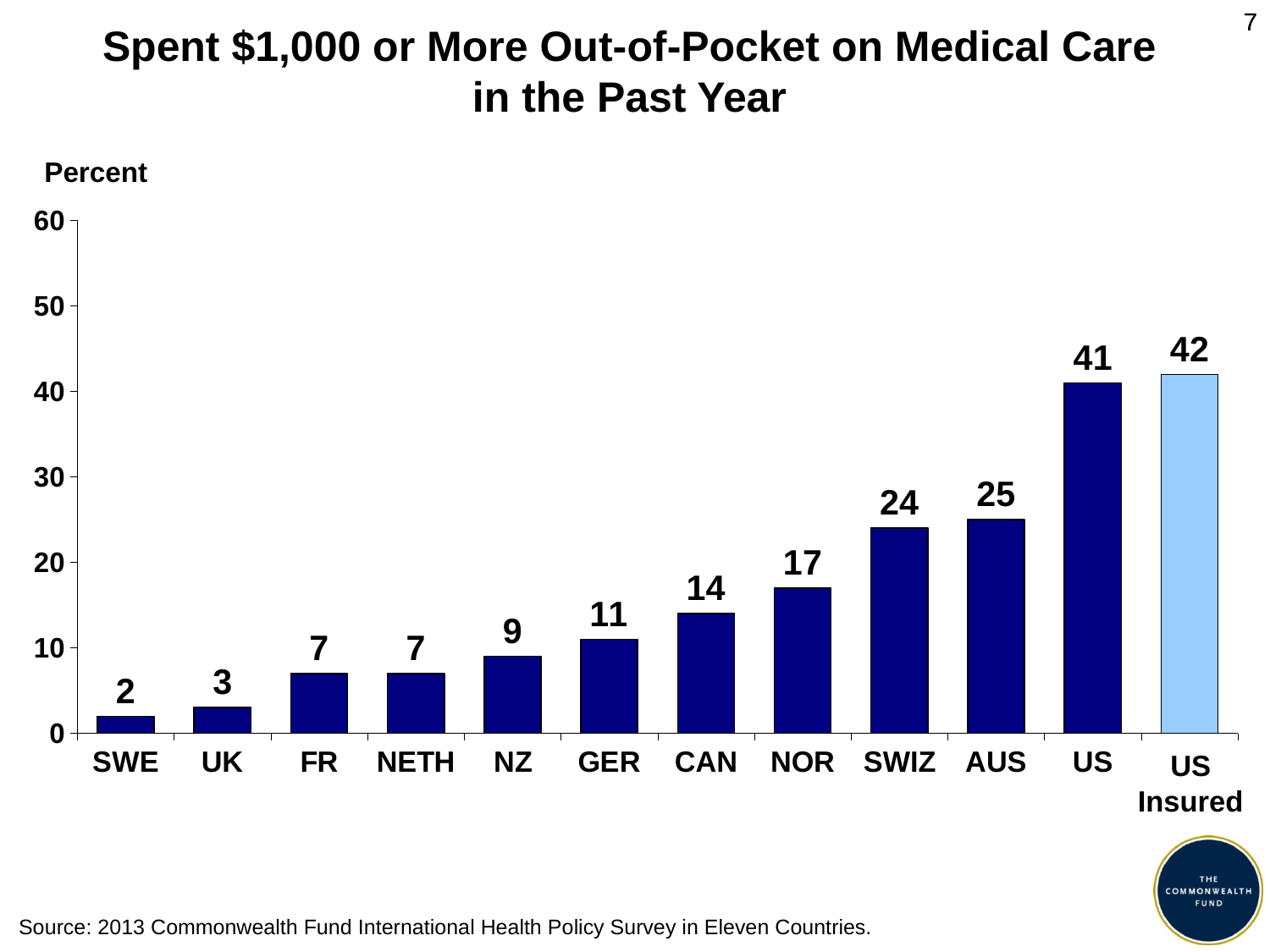
Which category has the highest value? US Insured What is the difference between the values for US and NOR? 24 Is the value for NZ greater or less than 10? less Do the values generally rise or fall from left to right along the x axis? rise What is the value for CAN? 14 What is the value for US Insured? 42 Which category has the lowest value? SWE What kind of chart is this? bar chart What is the label on the y axis? Percent How many categories are shown on the x axis? 12 What is the value for SWIZ? 24 Which is larger, the value for AUS or the value for GER? AUS